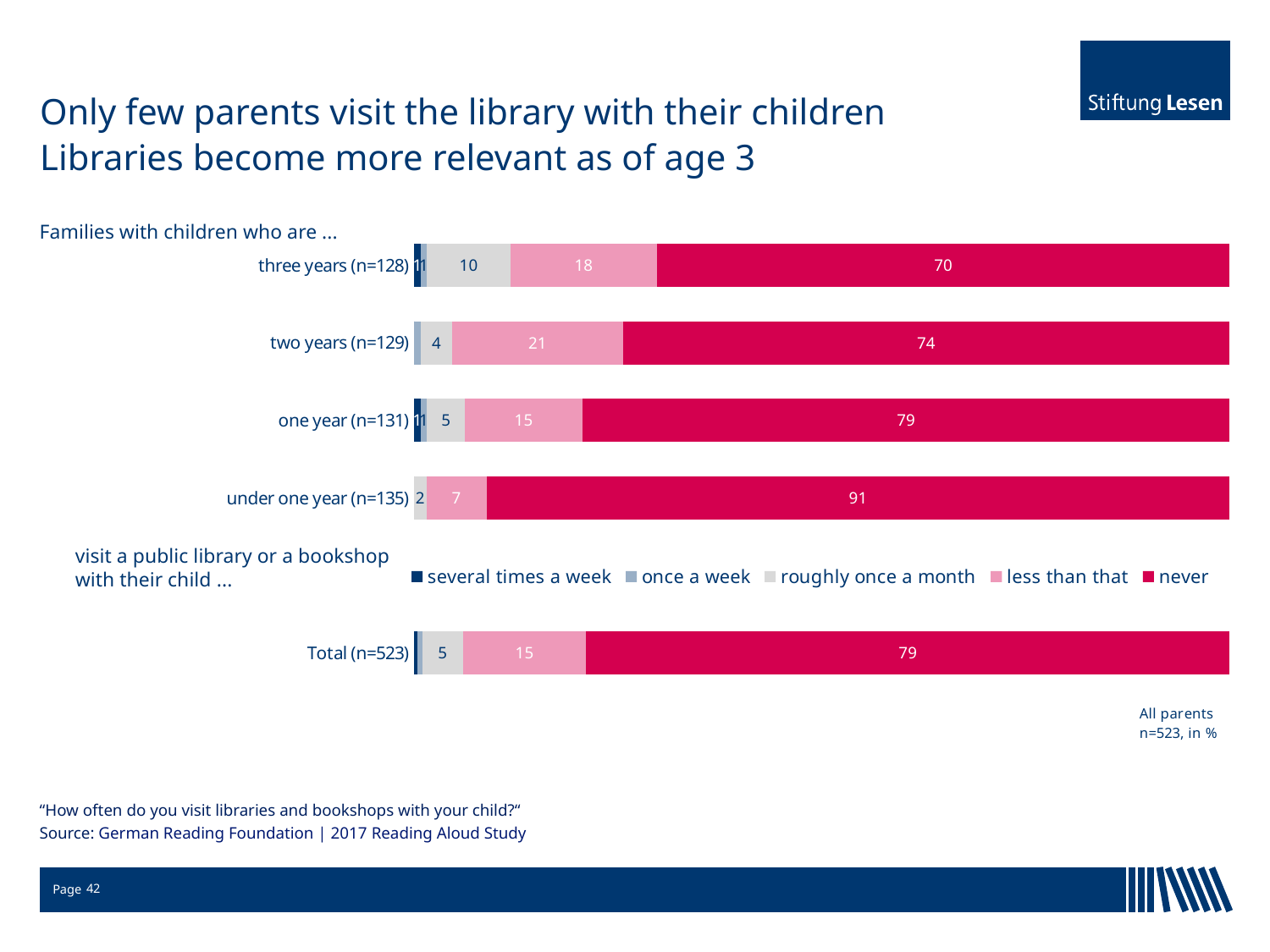
What is the 'never' value for families with children under one year? 91 What is the 'never' value for the Total (n=523) bar? 79 Which age group has the highest 'never' value? under one year (n=135) What is the difference between the 'never' values for under one year and three years? 21 What is the 'less than that' value for families with two-year-old children? 21 What percentage of families with three-year-old children never visit a public library or bookshop with their child? 70 What is the 'roughly once a month' value for the Total (n=523) bar? 5 What kind of chart is shown on the slide? stacked bar chart Which legend entry is shown in dark red? never How many series does the legend list? 5 Which age group has the lowest 'never' value? three years (n=128) Is the 'less than that' value larger for two years or for one year? two years